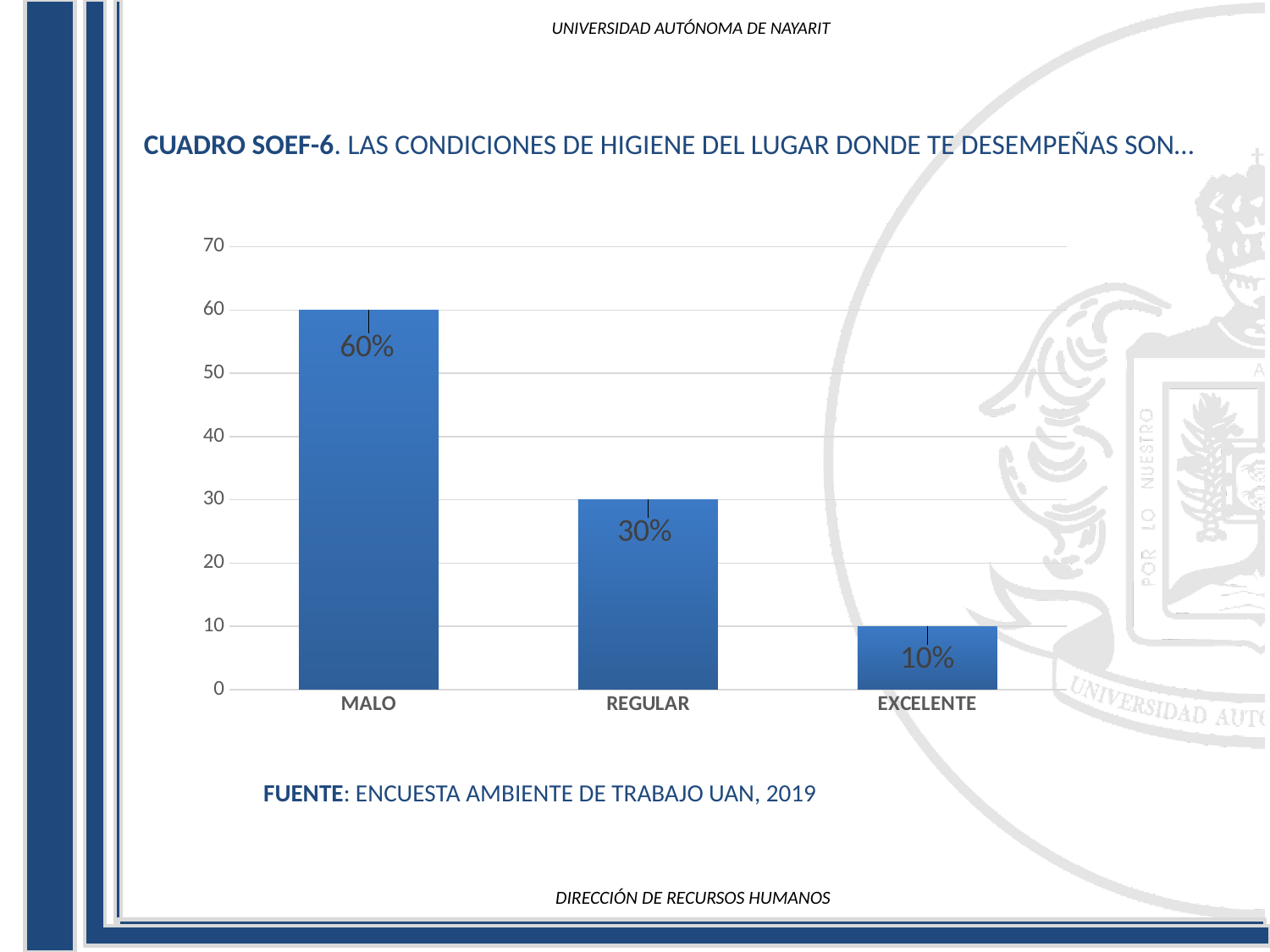
What kind of chart is shown on the slide? bar chart Which category has the highest value? MALO What is the value for MALO? 60% What is the difference between the values for MALO and REGULAR? 30% Is the value for MALO greater or less than 50? greater What is the difference between the values for REGULAR and EXCELENTE? 20% What is the value for REGULAR? 30% Which category has the lowest value? EXCELENTE Do the values rise or fall from left to right along the x axis? fall What is the value for EXCELENTE? 10% How many categories are shown on the x axis? 3 Which is larger, the value for REGULAR or the value for EXCELENTE? REGULAR